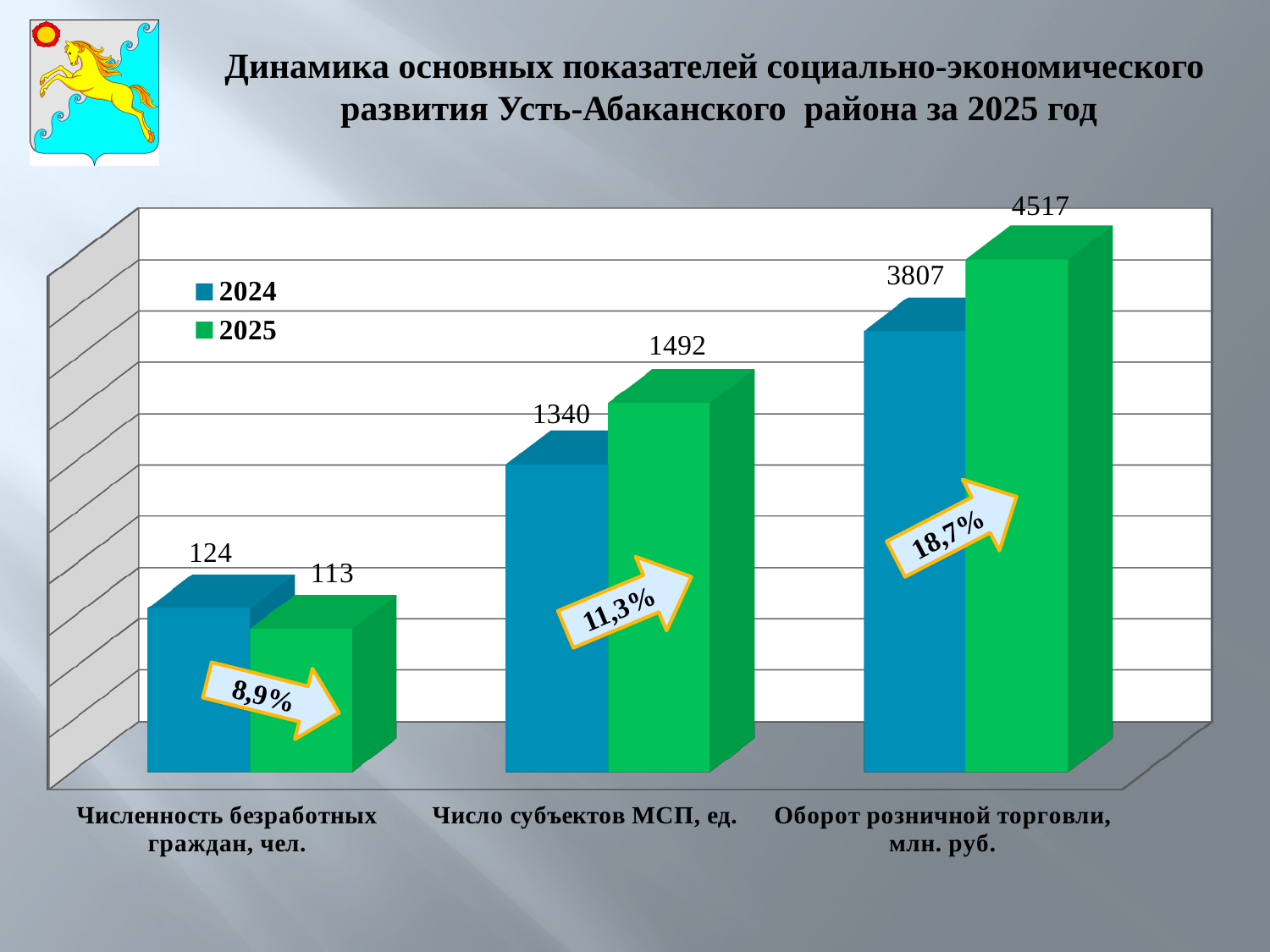
How many series does the chart legend list? 2 What is the value for 2024 in the category "Численность безработных граждан, чел."? 124 What kind of chart is shown on the slide? Bar chart What is the value for 2024 in the category "Число субъектов МСП, ед."? 1340 Which category has the lowest 2024 value? Численность безработных граждан, чел. What is the value for 2025 in the category "Оборот розничной торговли, млн. руб."? 4517 Which category has the highest 2025 value? Оборот розничной торговли, млн. руб. How many categories are shown on the x axis of the chart? 3 What is the difference between the 2025 and 2024 values for "Оборот розничной торговли, млн. руб."? 710 In the category "Численность безработных граждан, чел.", which year has the larger value, 2024 or 2025? 2024 What is the value for 2025 in the category "Численность безработных граждан, чел."? 113 What is the difference between the 2025 and 2024 values for "Число субъектов МСП, ед."? 152